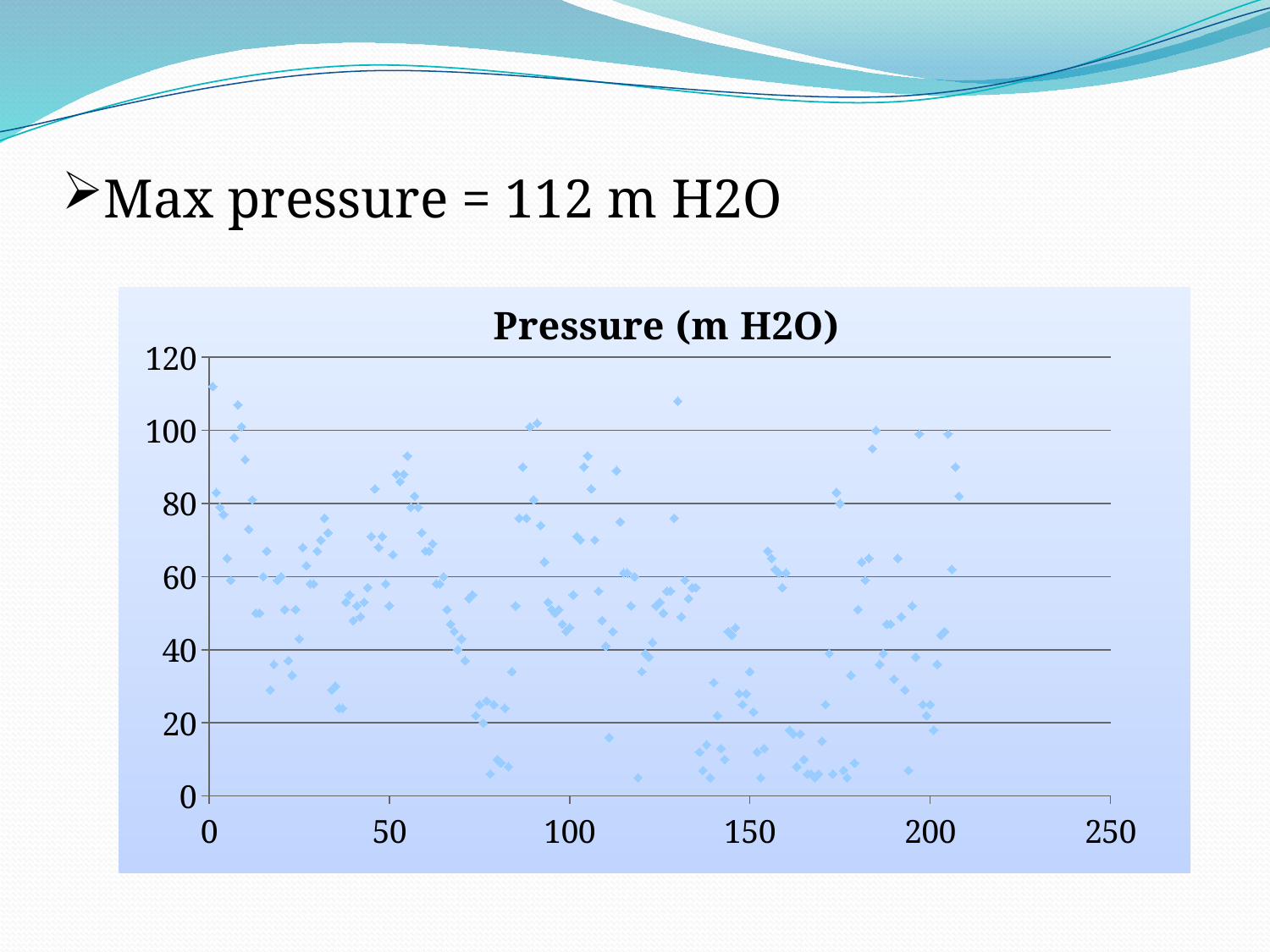
According to the slide, what is the maximum pressure? 112 m H2O Are there any plotted points beyond 250 on the x axis? No Is the lowest plotted pressure value greater or less than 20? less What kind of chart is shown on the slide? scatter chart What is the highest tick value shown on the y axis? 120 Is the highest plotted pressure value greater or less than 100? greater What is the title of the chart? Pressure (m H2O)